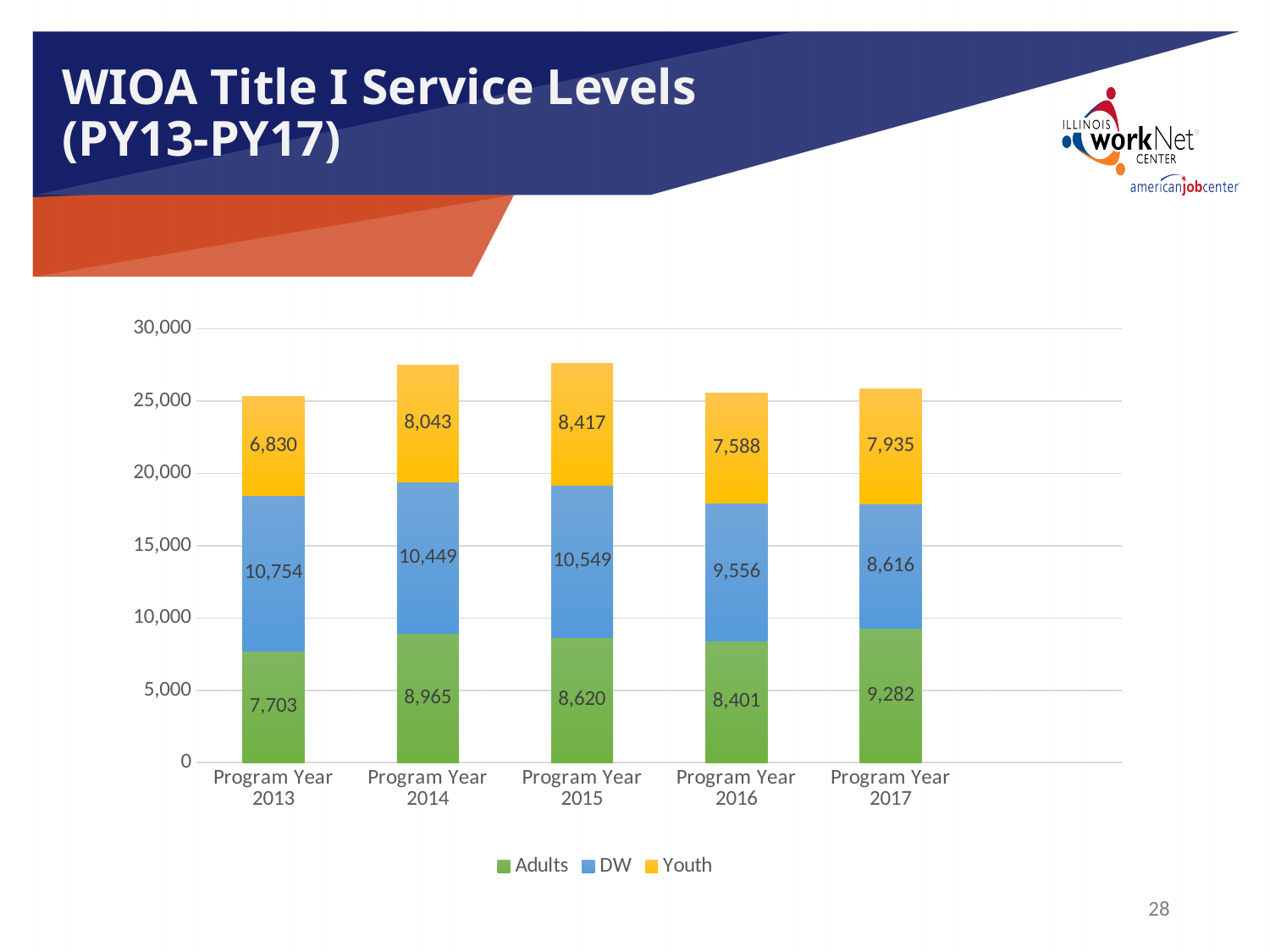
Which is larger, the Youth value for Program Year 2014 or for Program Year 2016? Program Year 2014 What is the Adults value for Program Year 2013? 7,703 What is the difference between the DW value for Program Year 2013 and Program Year 2017? 2,138 How many program years are shown on the x axis? 5 What is the Youth value for Program Year 2017? 7,935 Which program year has the highest Adults value? Program Year 2017 Which colour represents the DW series in the legend? Blue What is the DW value for Program Year 2015? 10,549 What kind of chart is shown on the slide? Stacked bar chart Which program year has the lowest Youth value? Program Year 2013 How many series does the legend list? 3 What is the total of the stacked bar for Program Year 2014? 27,457